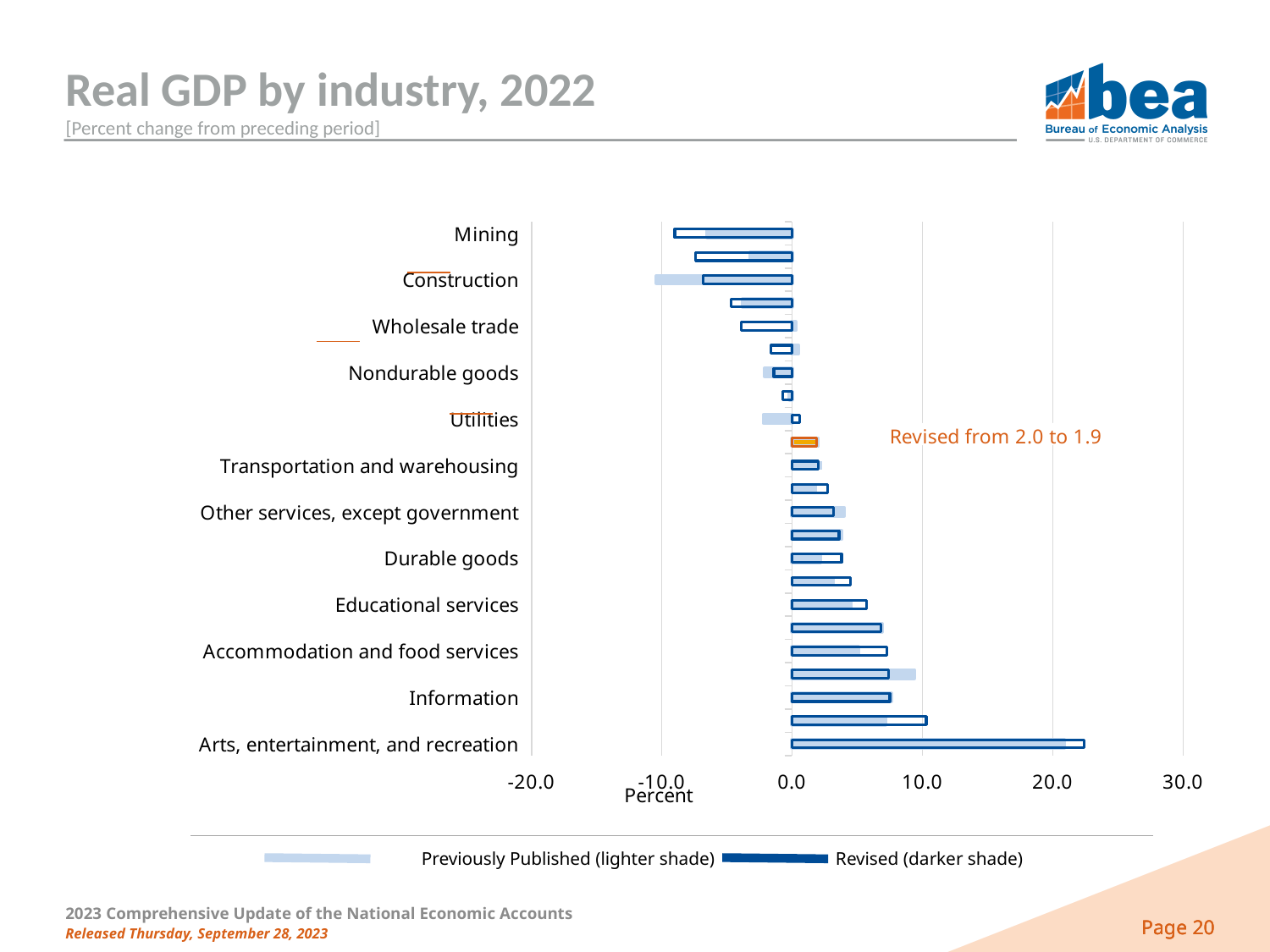
Which has the larger revised value, Information or Mining? Information How many series does the legend list? 2 Is the revised value for Information greater or less than 10.0? less According to the annotation on the chart, what was the highlighted value revised from and to? from 2.0 to 1.9 What is the title of the x axis? Percent Is the revised value for Arts, entertainment, and recreation greater or less than 20.0? greater Which industry has the lowest revised value? Mining Which industry has the highest revised value? Arts, entertainment, and recreation Is the revised value for Educational services greater or less than 0.0? greater What kind of chart is shown on the slide? bar chart Which has the larger revised value, Arts, entertainment, and recreation or Accommodation and food services? Arts, entertainment, and recreation